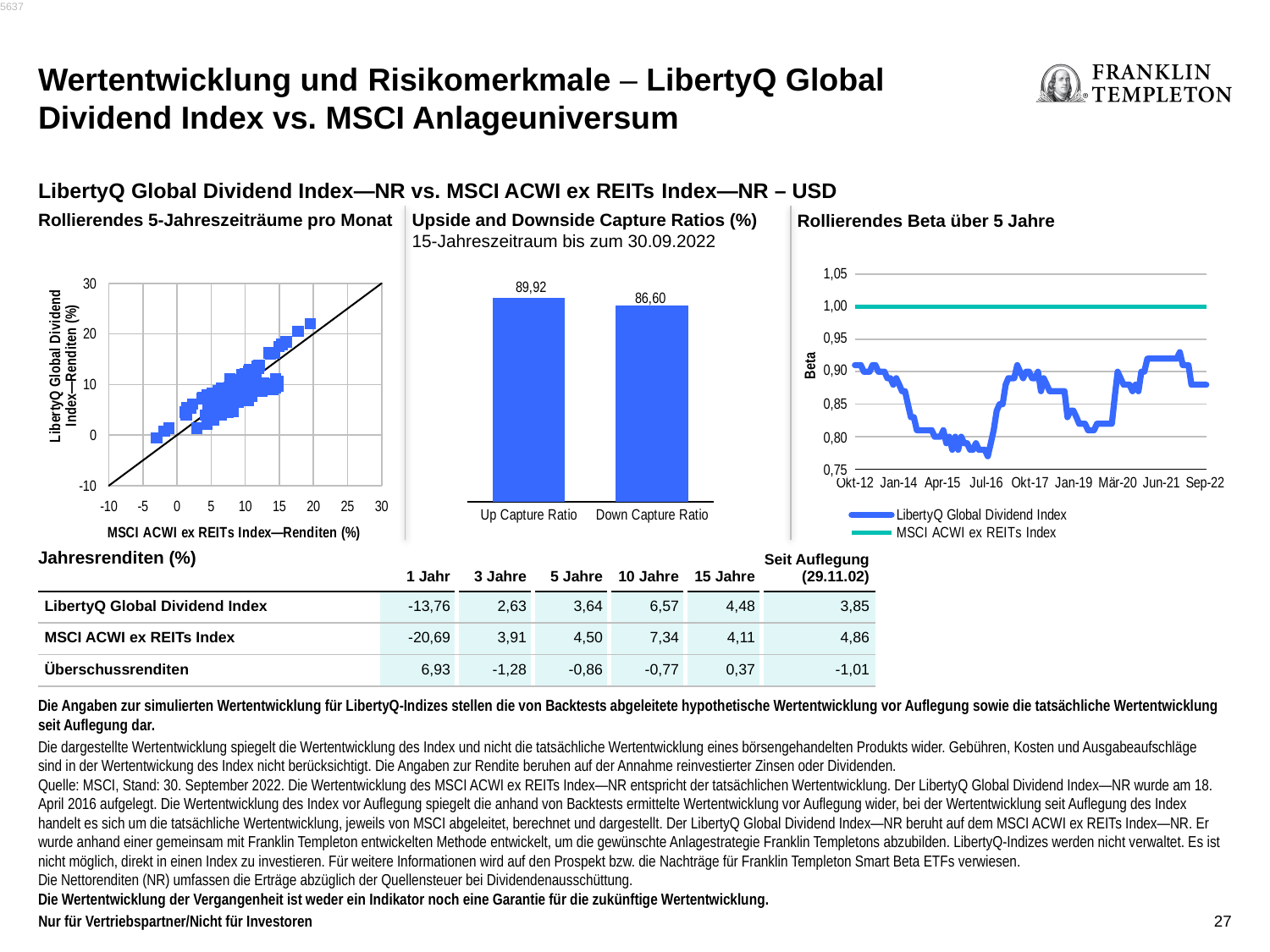
In the 'Rollierendes Beta über 5 Jahre' chart, at what constant value does the MSCI ACWI ex REITs Index line sit? 1,00 In the 'Upside and Downside Capture Ratios (%)' chart, what is the difference between the Up Capture Ratio and the Down Capture Ratio? 3,32 How many series does the legend of the 'Rollierendes Beta über 5 Jahre' chart list? 2 What is the x-axis label of the 'Rollierendes 5-Jahreszeiträume pro Monat' scatter chart? MSCI ACWI ex REITs Index—Renditen (%) What kind of chart is the 'Rollierendes Beta über 5 Jahre' chart? Line chart In the 'Rollierendes Beta über 5 Jahre' chart, is the LibertyQ Global Dividend Index beta around Jul-16 greater or less than 0,80? less How many bars are shown in the 'Upside and Downside Capture Ratios (%)' chart? 2 In the 'Rollierendes Beta über 5 Jahre' chart, which series is higher throughout the period, LibertyQ Global Dividend Index or MSCI ACWI ex REITs Index? MSCI ACWI ex REITs Index In the 'Upside and Downside Capture Ratios (%)' chart, which bar is higher, Up Capture Ratio or Down Capture Ratio? Up Capture Ratio In the 'Upside and Downside Capture Ratios (%)' chart, what is the value of the Down Capture Ratio? 86,60 What kind of chart is the 'Upside and Downside Capture Ratios (%)' chart? Bar chart In the 'Upside and Downside Capture Ratios (%)' chart, what is the value of the Up Capture Ratio? 89,92